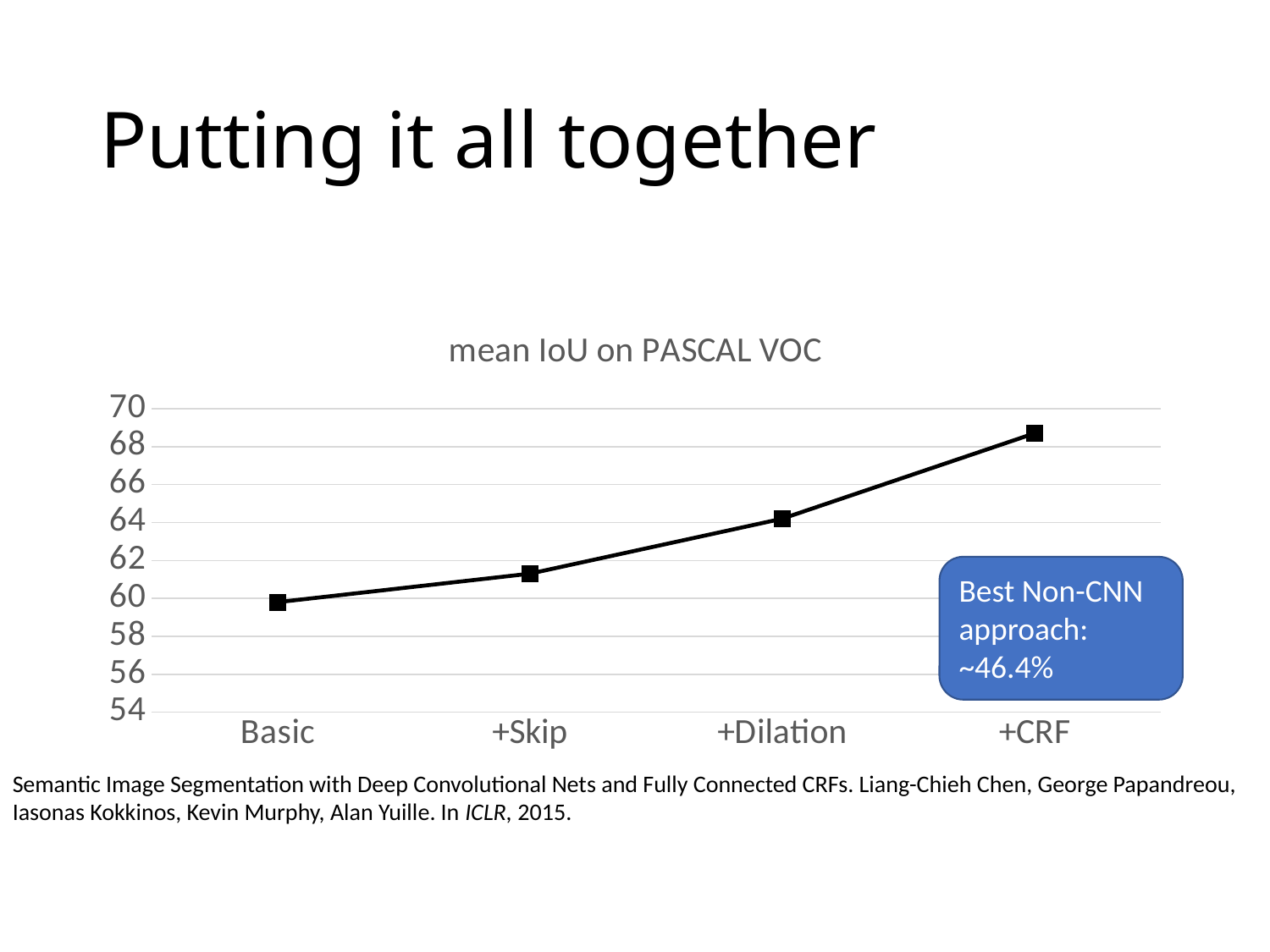
What kind of chart is shown on the slide? line chart Do the values rise or fall from Basic to +CRF along the x axis? rise Is the value for Basic greater or less than 62? less Is the value for +Skip greater or less than 60? greater How many categories are plotted along the x axis? 4 Which category has the highest mean IoU? +CRF Which has a higher mean IoU, +Skip or +Dilation? +Dilation Is the value for +Dilation greater or less than 62? greater Which category has the lowest mean IoU? Basic What is the title of the chart? mean IoU on PASCAL VOC What value does the callout box give for the best non-CNN approach? ~46.4%